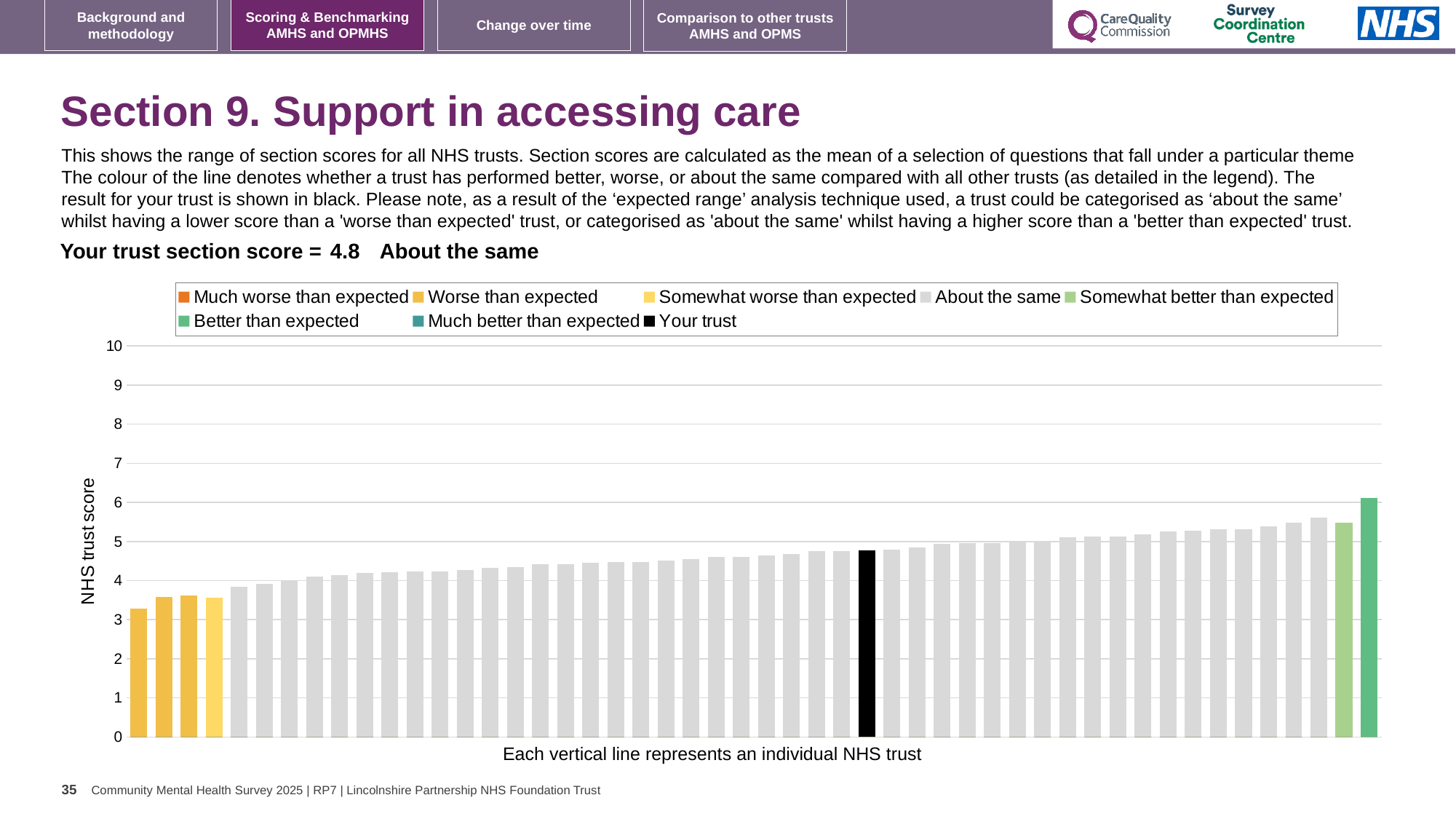
Do the bar values rise or fall from left to right along the x axis? rise What kind of chart is shown on the slide? bar chart Is the value of the black 'Your trust' bar greater or less than 4? greater Is the tallest bar in the chart coloured green or grey? green Is the value of the black 'Your trust' bar greater or less than 5? less How many entries does the chart legend list? 8 What is your trust's section score as printed on the slide? 4.8 How many yellow (worse than expected) bars are shown at the left of the chart? 4 Is the value of the lowest bar in the chart greater or less than 3? greater What is the label on the vertical axis of the chart? NHS trust score Which category is your trust placed in for this section, according to the text above the chart? About the same